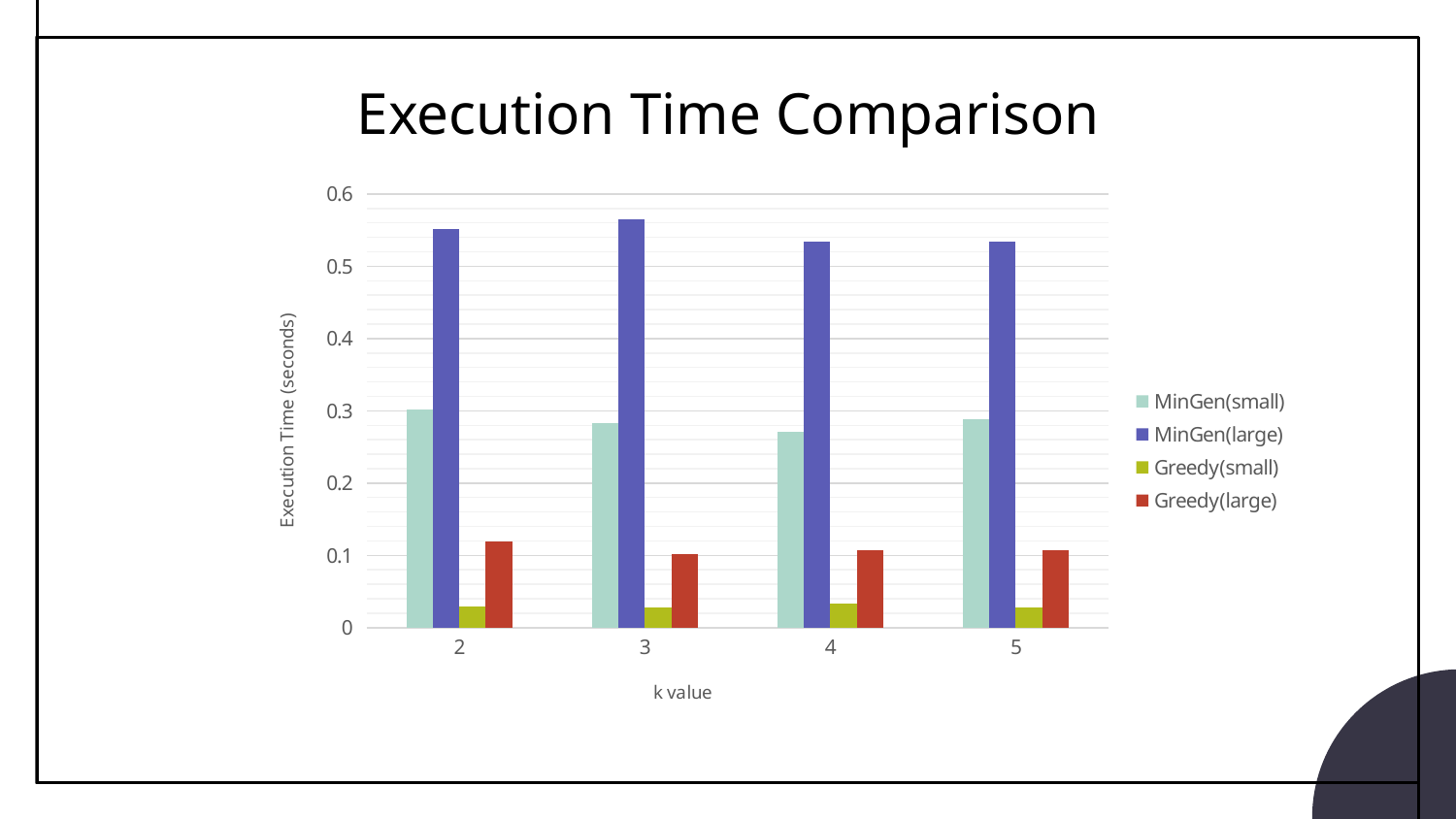
What is the label of the y axis? Execution Time (seconds) Is the value for MinGen(large) at k value 2 greater or less than 0.5? greater Which series has the highest execution time at k value 3? MinGen(large) Is the value for Greedy(large) at k value 2 greater or less than 0.1? greater What is the title of the chart? Execution Time Comparison What kind of chart is shown on the slide? bar chart At k value 4, which is larger: MinGen(small) or Greedy(large)? MinGen(small) Is the value for Greedy(small) at k value 4 greater or less than 0.1? less How many series does the legend list? 4 How many k values are shown on the x axis? 4 Which series has the lowest execution time at k value 5? Greedy(small)